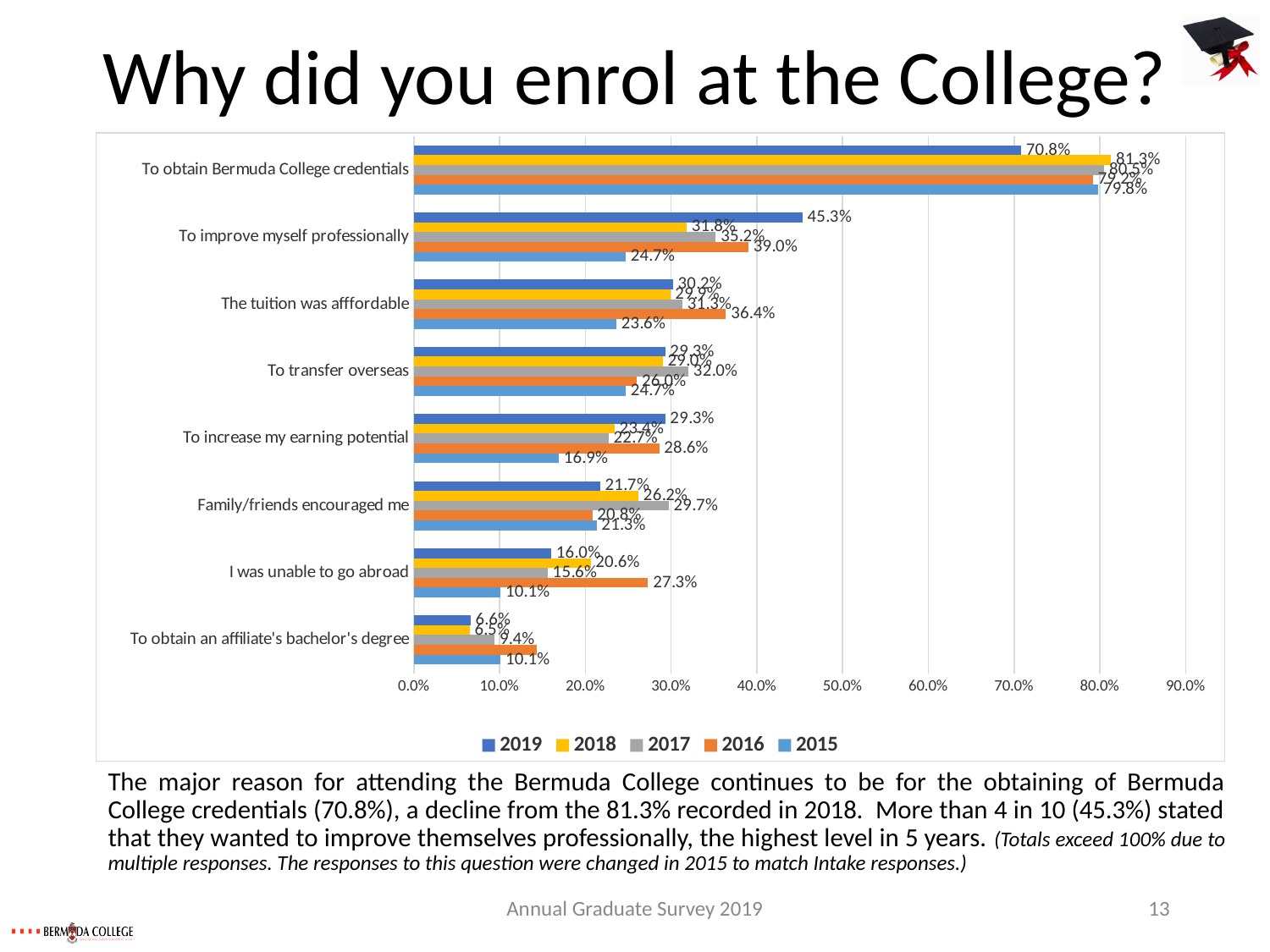
Is the 2016 value for 'The tuition was affordable' greater or less than 30.0%? greater How many reasons for enrolling are listed on the chart? 8 For 'To improve myself professionally', which year has the larger value, 2019 or 2015? 2019 What is the 2018 value for 'To obtain Bermuda College credentials'? 81.3% Which reason has the highest 2019 value? To obtain Bermuda College credentials What is the 2019 value for 'To obtain Bermuda College credentials'? 70.8% What kind of chart is shown on the slide? bar chart What is the difference between the 2018 and 2019 values for 'To obtain Bermuda College credentials'? 10.5% What is the 2019 value for 'To improve myself professionally'? 45.3% What is the 2016 value for 'I was unable to go abroad'? 27.3% How many series does the legend list? 5